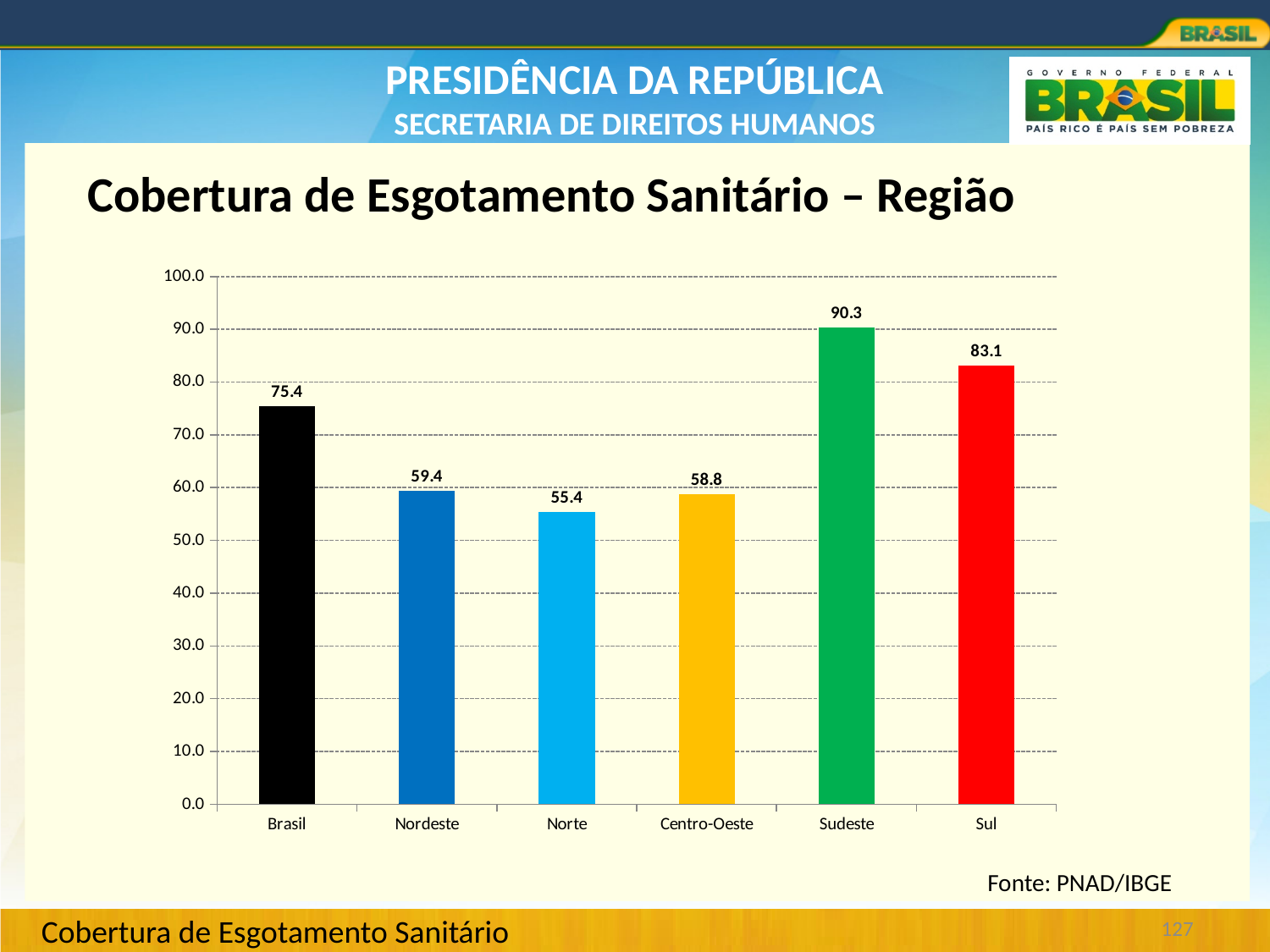
What is the value for Norte? 55.4 How many categories are shown on the x axis? 6 Which category has the lowest value? Norte Which category has the highest value? Sudeste What kind of chart is shown on the slide? Bar chart What is the difference between the values for Brasil and Nordeste? 16.0 What is the title of the chart? Cobertura de Esgotamento Sanitário – Região What is the value for Brasil? 75.4 What is the value for Sudeste? 90.3 Which is larger, the value for Nordeste or the value for Centro-Oeste? Nordeste What is the difference between the values for Sudeste and Sul? 7.2 What is the value for Centro-Oeste? 58.8